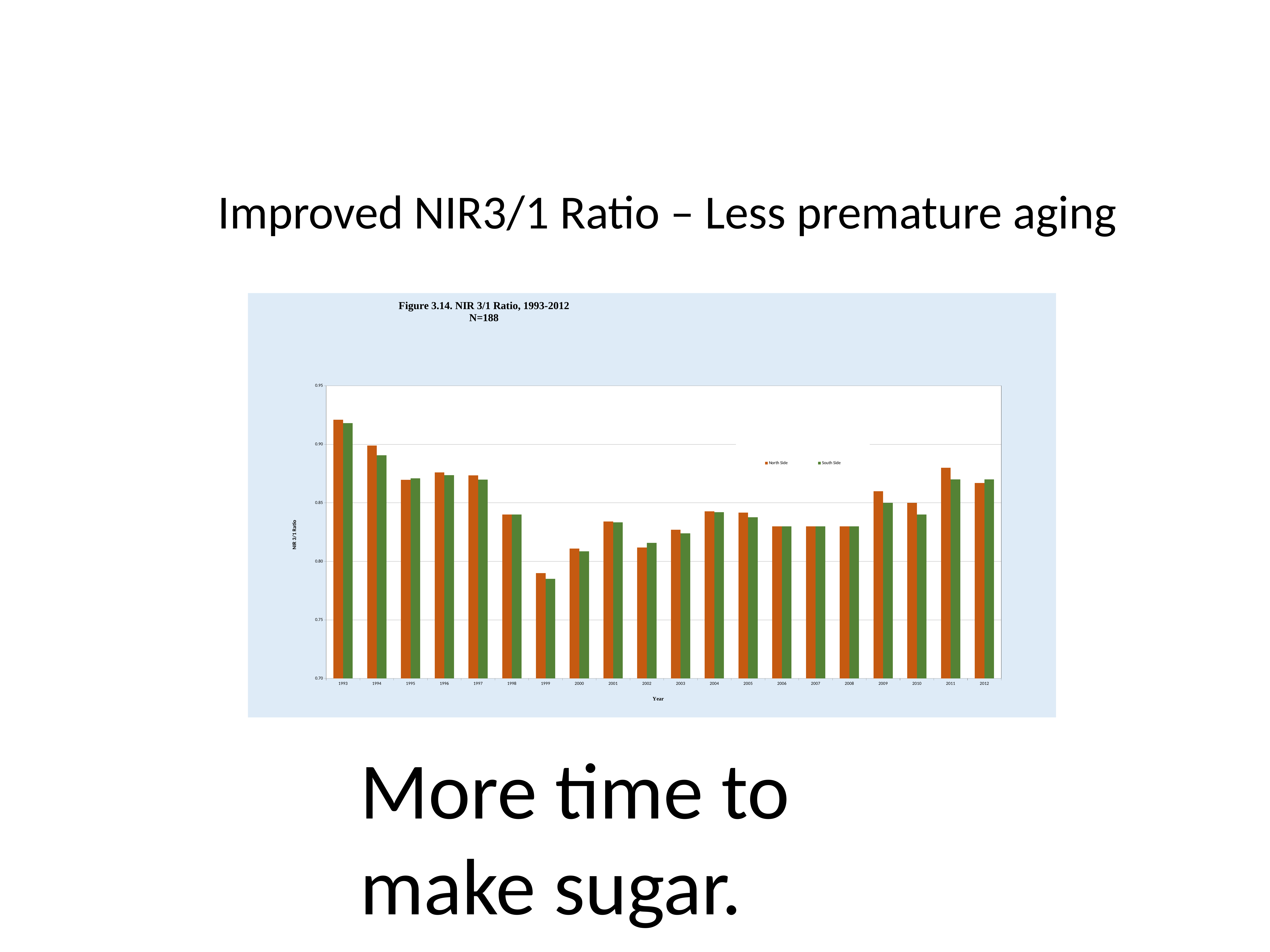
Which year has the lowest North Side NIR 3/1 ratio? 1999 How many series does the chart's legend list? 2 Which is larger, the North Side value for 1993 or the North Side value for 1999? 1993 Is the North Side value for 1993 greater or less than 0.90? greater Do the North Side values rise or fall from 1993 to 1999? Fall What is the sample size (N) stated in the chart title? N=188 Is the North Side value for 1999 greater or less than 0.80? less In 1994, which series has the larger value, North Side or South Side? North Side What kind of chart is shown on the slide? Bar chart Is the South Side value for 2006 greater or less than 0.85? less How many years are shown along the x axis of the chart? 20 Which year has the highest North Side NIR 3/1 ratio? 1993